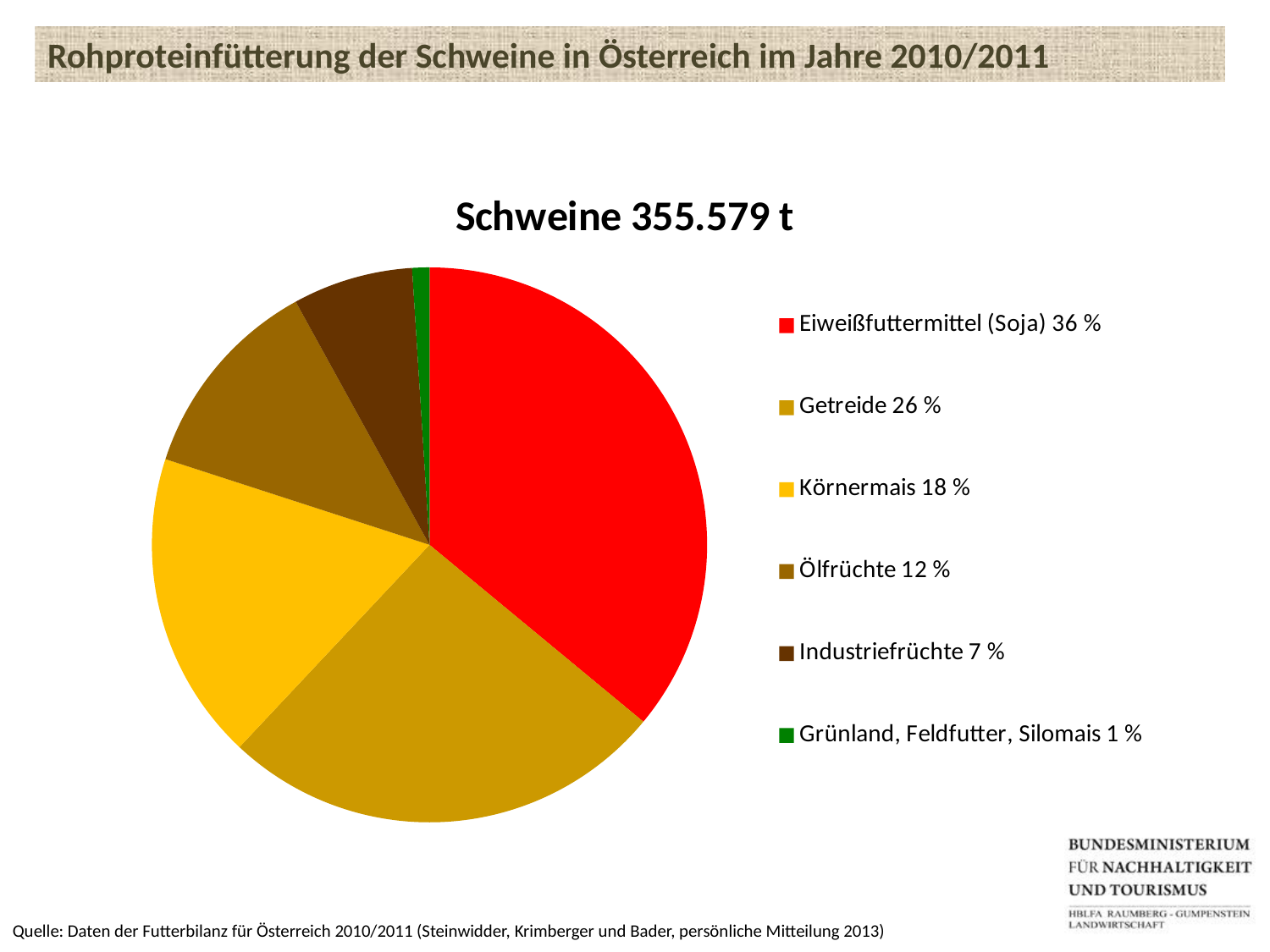
Which category has the smallest share of the pie? Grünland, Feldfutter, Silomais What is the difference in percentage points between Getreide and Ölfrüchte? 14 What share of the pie does Industriefrüchte have? 7 % What share of the pie does Getreide have? 26 % What share of the pie does Eiweißfuttermittel (Soja) have? 36 % How many slices does the pie chart have? 6 What is the title of the chart? Schweine 355.579 t What kind of chart is shown on the slide? pie chart Which category has the largest share of the pie? Eiweißfuttermittel (Soja) Which is larger, the share for Körnermais or the share for Industriefrüchte? Körnermais What colour is the slice for Grünland, Feldfutter, Silomais? green